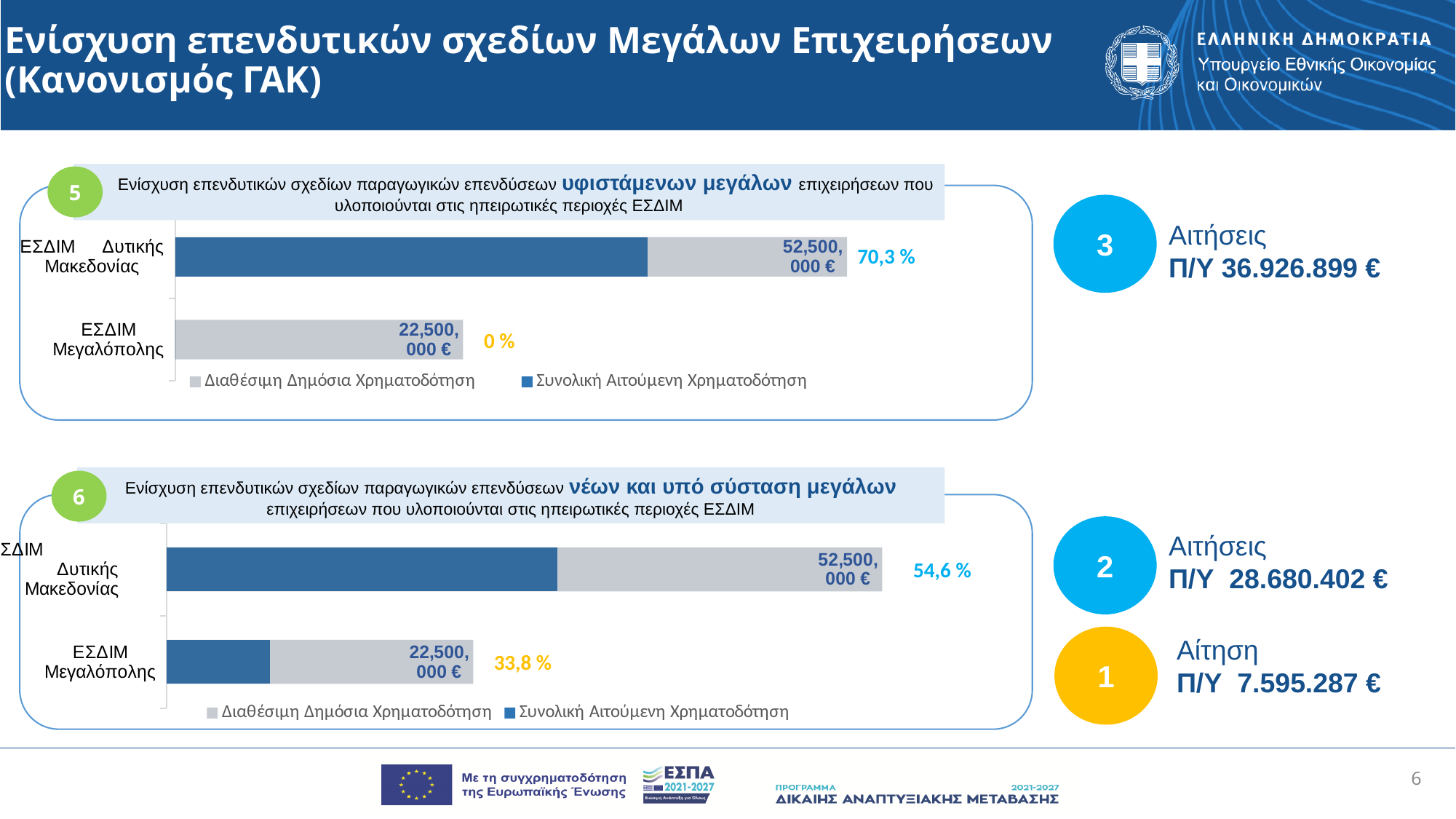
In the bottom chart (6), which category has the lower Διαθέσιμη Δημόσια Χρηματοδότηση? ΕΣΔΙΜ Μεγαλόπολης How many series does the legend of the bottom chart (6) list? 2 How many categories are plotted in the top chart (5)? 2 In the bottom chart (6), what percentage is shown next to the ΕΣΔΙΜ Μεγαλόπολης bar? 33,8 % In the bottom chart (6), what is the difference between the Διαθέσιμη Δημόσια Χρηματοδότηση values for ΕΣΔΙΜ Δυτικής Μακεδονίας and ΕΣΔΙΜ Μεγαλόπολης? 30,000,000 € In the top chart (5), what is the Διαθέσιμη Δημόσια Χρηματοδότηση value shown for ΕΣΔΙΜ Δυτικής Μακεδονίας? 52,500,000 € In the top chart (5), what percentage is shown next to the ΕΣΔΙΜ Μεγαλόπολης bar? 0 % In the top chart (5), what is the Διαθέσιμη Δημόσια Χρηματοδότηση value shown for ΕΣΔΙΜ Μεγαλόπολης? 22,500,000 € In the bottom chart (6), what percentage is shown next to the ΕΣΔΙΜ Δυτικής Μακεδονίας bar? 54,6 % In the top chart (5), which category has the higher Διαθέσιμη Δημόσια Χρηματοδότηση? ΕΣΔΙΜ Δυτικής Μακεδονίας What kind of chart is the bottom chart (6)? Bar chart In the top chart (5), what percentage is shown next to the ΕΣΔΙΜ Δυτικής Μακεδονίας bar? 70,3 %